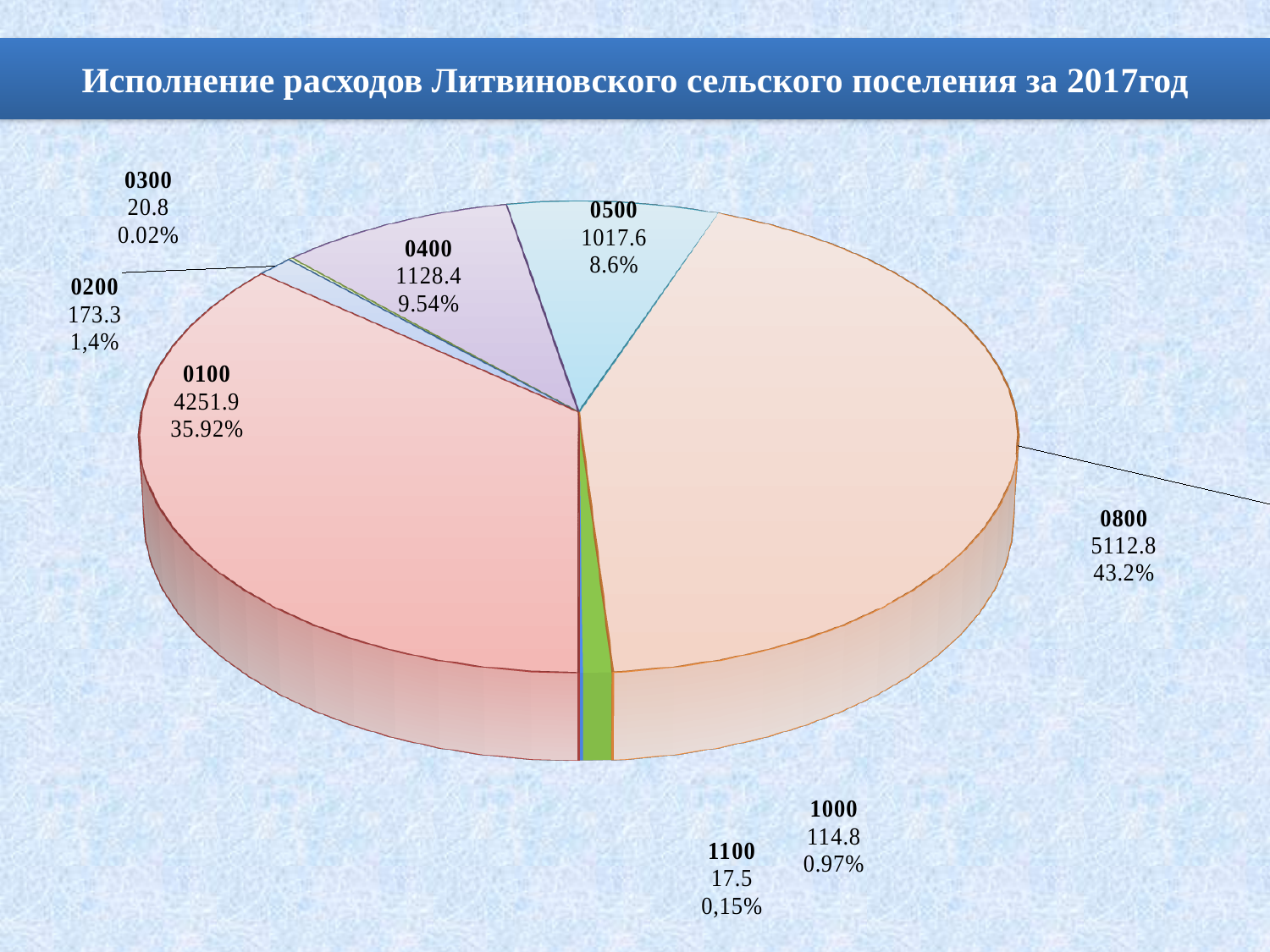
What kind of chart is shown on the slide? pie chart What is the difference between the values for 0800 and 0100? 860.9 Which category has the largest slice of the pie? 0800 What is the value shown for category 0200? 173.3 What is the value shown for category 0800? 5112.8 What is the value shown for category 0500? 1017.6 What share of the pie does category 0800 represent? 43.2% What is the value shown for category 0400? 1128.4 How many categories are shown in the pie chart? 8 What is the value shown for category 0100? 4251.9 Which is larger, the value for 0400 or the value for 0500? 0400 Which category has the smallest value in the pie? 1100